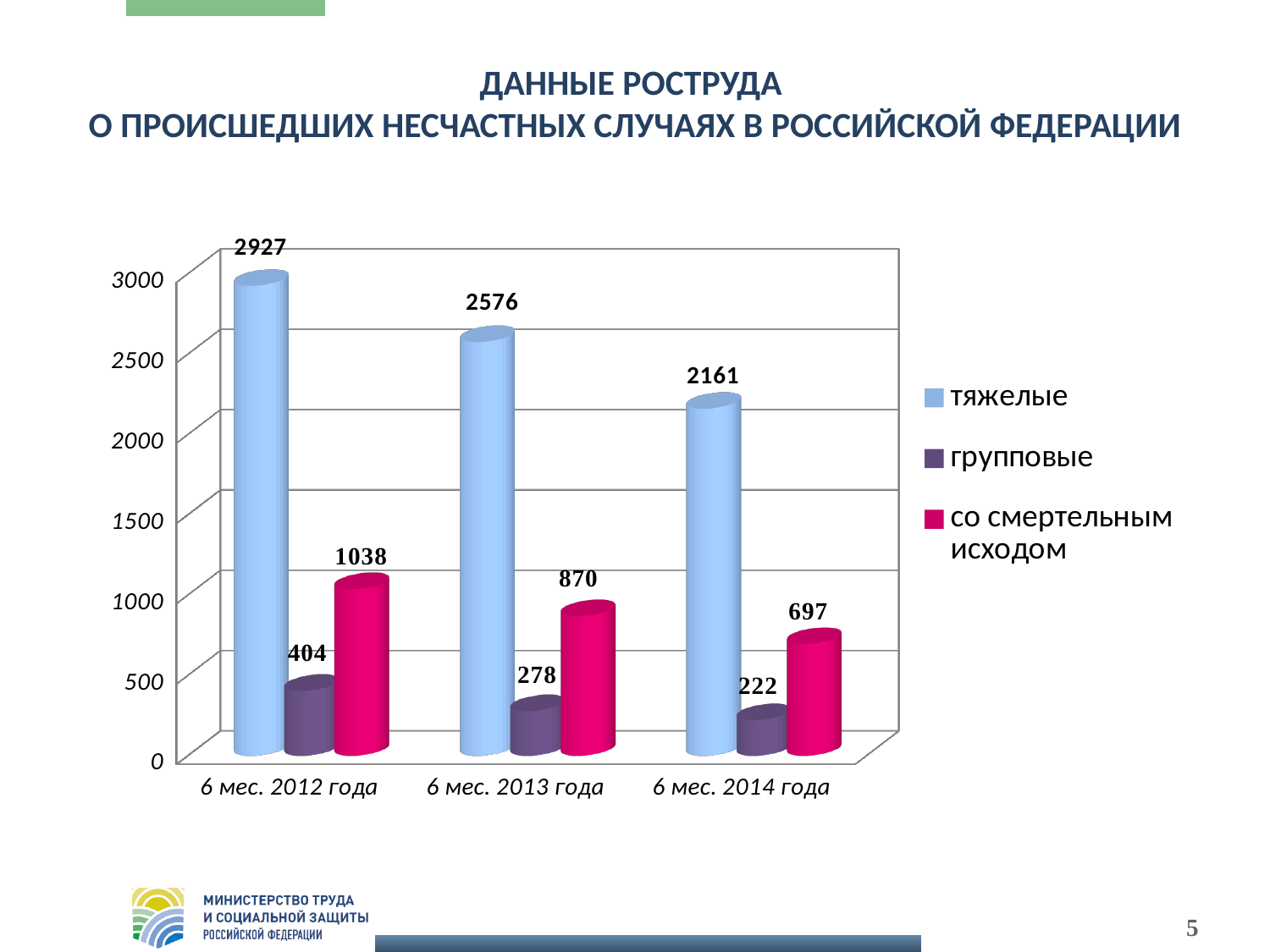
What is the value for групповые in 6 мес. 2014 года? 222 How many periods are shown on the x axis? 3 In which period is the value for групповые the lowest? 6 мес. 2014 года What is the difference between the тяжелые values for 6 мес. 2012 года and 6 мес. 2014 года? 766 How many series does the legend list? 3 What is the value for со смертельным исходом in 6 мес. 2013 года? 870 Do the values for тяжелые rise or fall from 6 мес. 2012 года to 6 мес. 2014 года? fall What is the value for тяжелые in 6 мес. 2012 года? 2927 Which is larger: групповые in 6 мес. 2012 года or со смертельным исходом in 6 мес. 2014 года? со смертельным исходом in 6 мес. 2014 года What is the difference between the со смертельным исходом values for 6 мес. 2012 года and 6 мес. 2013 года? 168 In which period is the value for тяжелые the highest? 6 мес. 2012 года What kind of chart is shown on the slide? bar chart